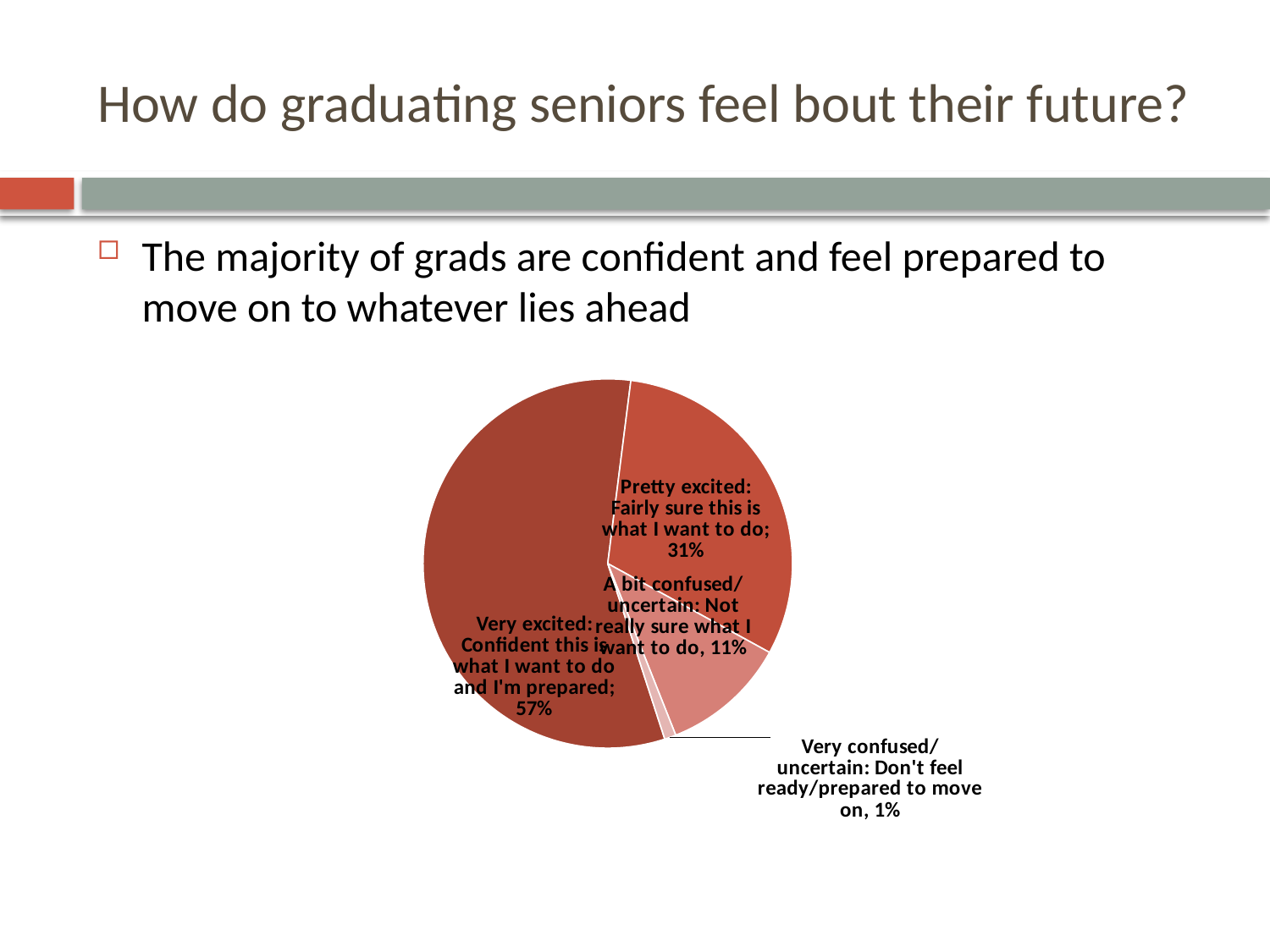
What share of graduating seniors are 'A bit confused/uncertain: Not really sure what I want to do'? 11% Which category has the largest slice of the pie? Very excited: Confident this is what I want to do and I'm prepared What is the difference in percentage points between the 'Very excited' slice and the 'Pretty excited' slice? 26 How many slices does the pie chart have? 4 What share of graduating seniors are 'Very confused/uncertain: Don't feel ready/prepared to move on'? 1% Which is larger: the 'Pretty excited' slice or the 'A bit confused/uncertain' slice? Pretty excited What share of graduating seniors are 'Very excited: Confident this is what I want to do and I'm prepared'? 57% What is the title of the slide containing the pie chart? How do graduating seniors feel bout their future? What is the combined share of the 'A bit confused/uncertain' and 'Very confused/uncertain' slices? 12% Which category has the smallest slice of the pie? Very confused/uncertain: Don't feel ready/prepared to move on What kind of chart is shown on the slide? pie chart What share of graduating seniors are 'Pretty excited: Fairly sure this is what I want to do'? 31%